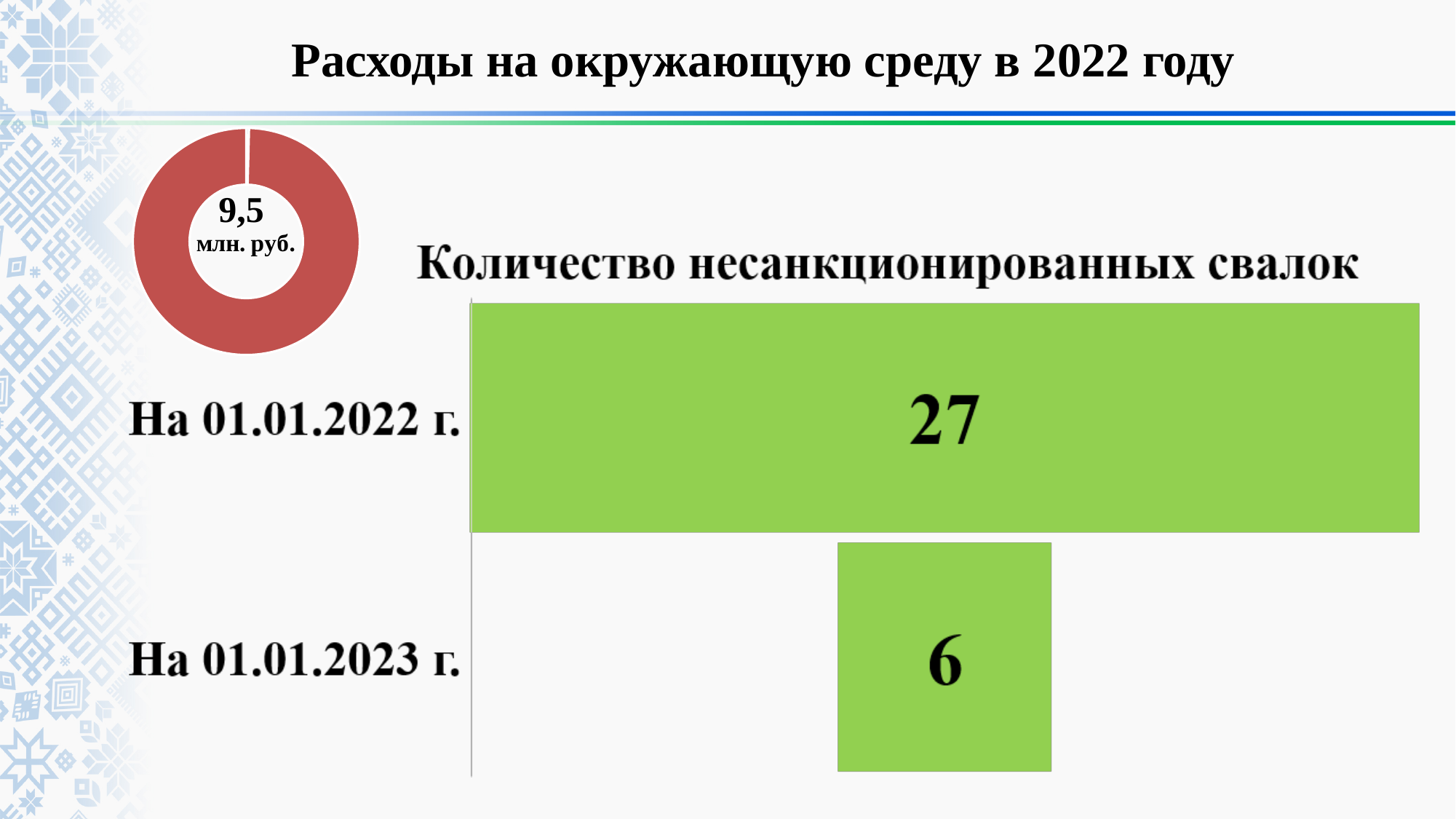
What value is printed in the centre of the donut chart on the left of the slide? 9,5 млн. руб. In the chart titled "Количество несанкционированных свалок", which category has the highest value? На 01.01.2022 г. What colour are the bars in the chart titled "Количество несанкционированных свалок"? green In the chart titled "Количество несанкционированных свалок", do the values rise or fall from "На 01.01.2022 г." to "На 01.01.2023 г."? fall In the chart titled "Количество несанкционированных свалок", what is the value for "На 01.01.2023 г."? 6 In the chart titled "Количество несанкционированных свалок", which category has the lowest value? На 01.01.2023 г. What kind of chart is the one titled "Количество несанкционированных свалок"? bar chart In the chart titled "Количество несанкционированных свалок", which is larger: the value for "На 01.01.2022 г." or for "На 01.01.2023 г."? На 01.01.2022 г. What kind of chart is the one on the left side of the slide, below the title? donut chart In the chart titled "Количество несанкционированных свалок", what is the value for "На 01.01.2022 г."? 27 In the chart titled "Количество несанкционированных свалок", what is the difference between the values for "На 01.01.2022 г." and "На 01.01.2023 г."? 21 How many categories are shown in the chart titled "Количество несанкционированных свалок"? 2